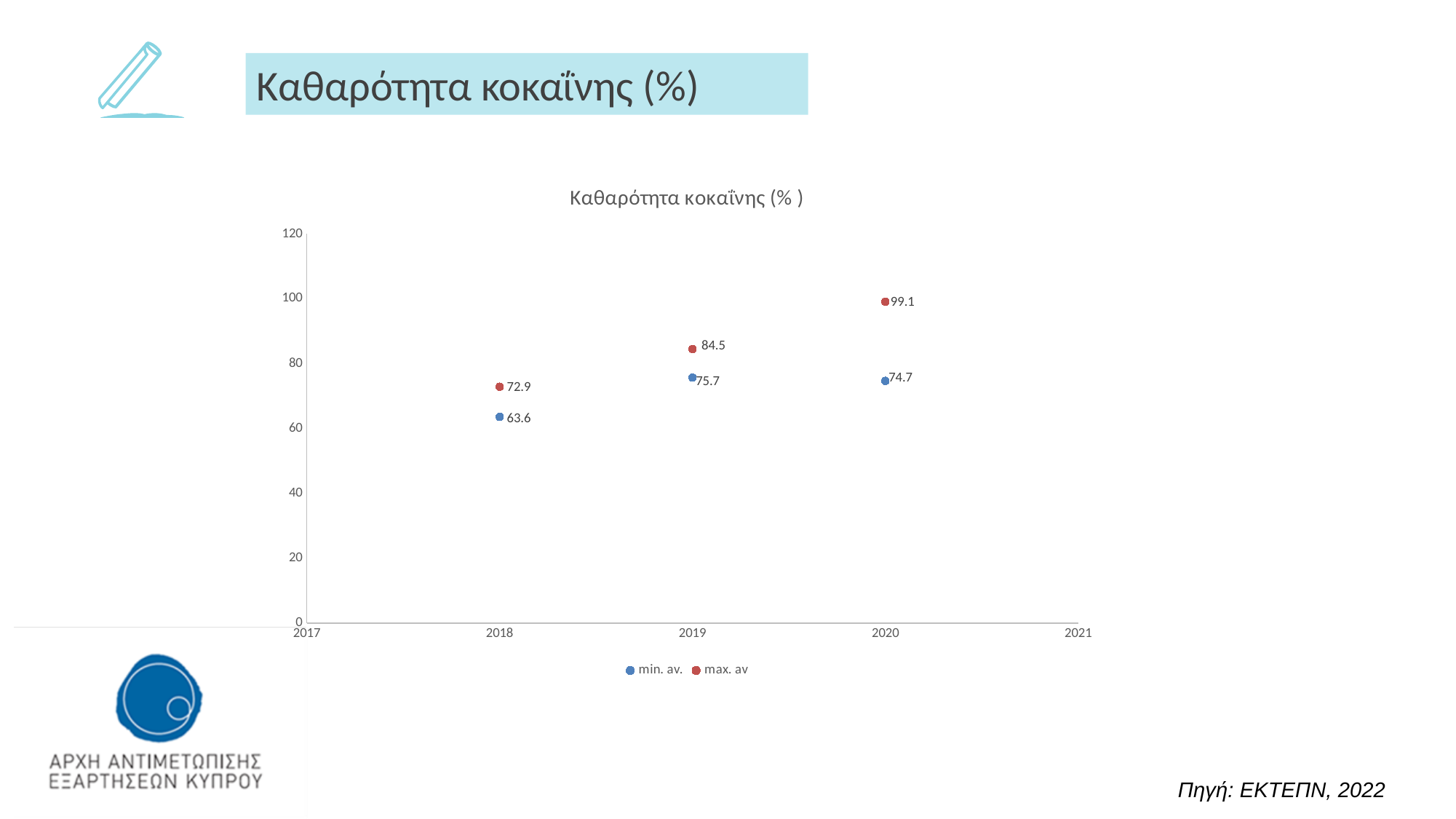
What is the value of the min. av. series for 2018? 63.6 What is the difference between the max. av and min. av. values in 2020? 24.4 What is the value of the min. av. series for 2019? 75.7 How many years have data points plotted on the chart? 3 Which is larger, the max. av value for 2019 or the max. av value for 2018? max. av value for 2019 In which year is the max. av value highest? 2020 Does the max. av series rise or fall from 2018 to 2020? rise In which year is the min. av. value lowest? 2018 What colour are the markers for the max. av series? red What is the value of the max. av series for 2020? 99.1 How many series does the legend list? 2 What is the value of the max. av series for 2018? 72.9